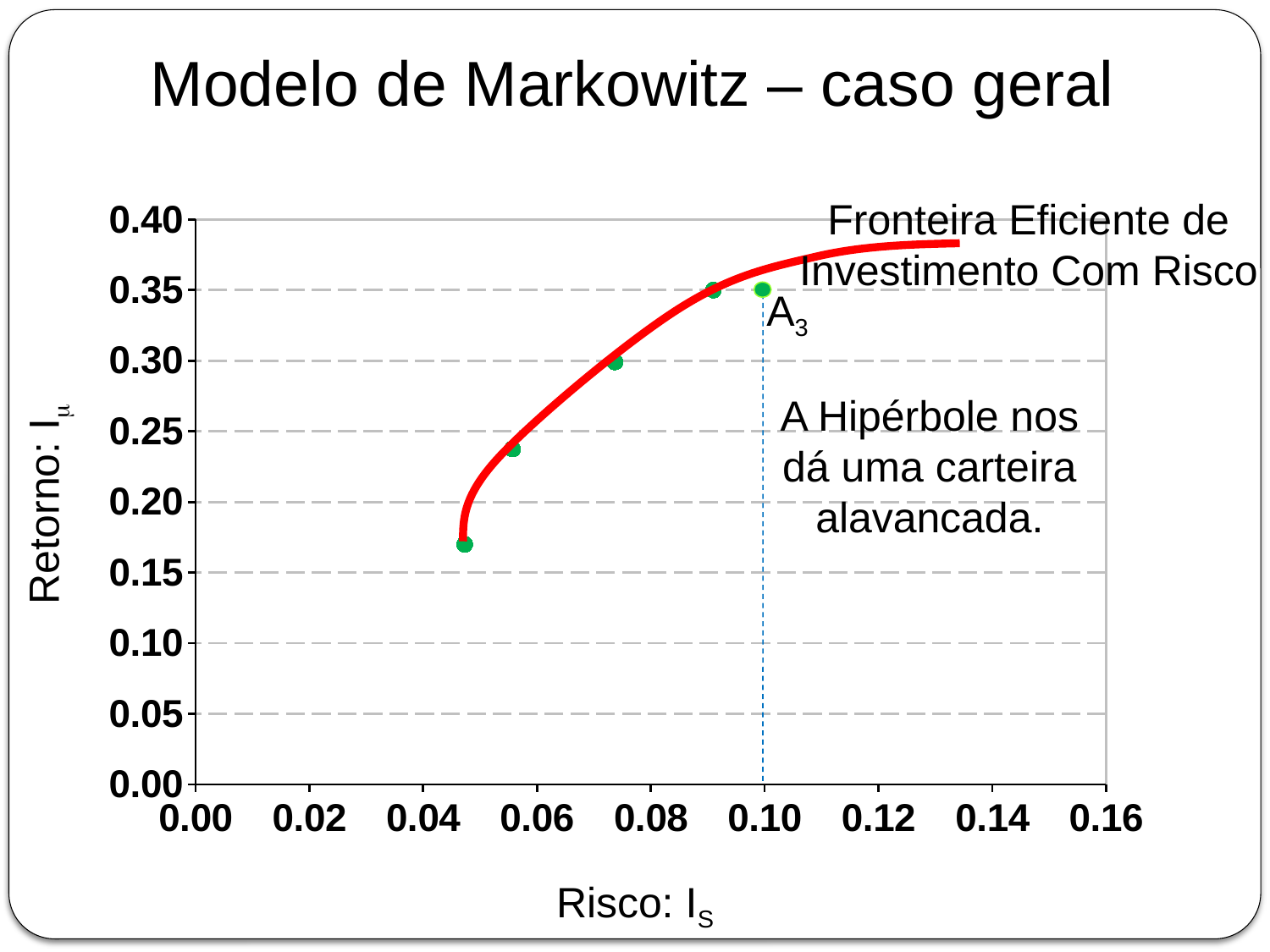
Which has the higher return: the point A3 or the leftmost green point? A3 What is the highest value shown on the y axis? 0.40 How many green data points are plotted on the chart? 5 Is the return of the leftmost green point (at the lowest risk) greater or less than 0.15? greater Does the red curve rise or fall as risk increases along the x axis? rises What is the return (y-axis) value of the point labelled A3? 0.35 Is the return of the green point at a risk of about 0.056 greater or less than 0.25? less What kind of chart is shown on the slide? line chart What name does the slide give to the red curve? Fronteira Eficiente de Investimento Com Risco What is the label of the x axis? Risco: I_S What is the risk (x-axis) value of the point labelled A3? 0.10 Is the highest return reached by the red curve greater or less than 0.40? less